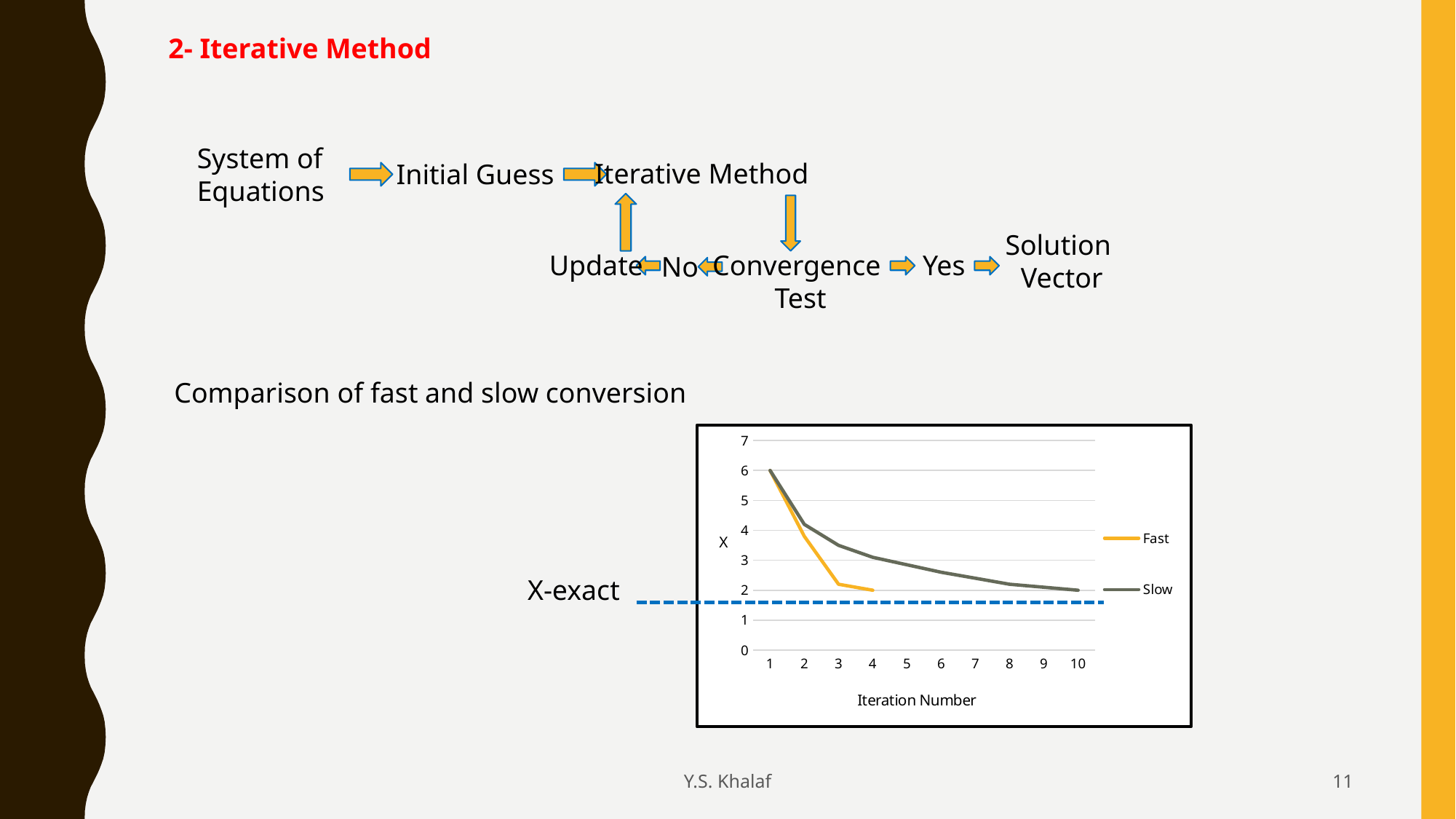
How many iteration numbers are shown on the chart's x axis? 10 At iteration 3, which series has the higher value, Fast or Slow? Slow What kind of chart is shown on the slide? line chart Is the value of the Fast series at iteration 2 greater or less than 5? less Is the value of the Slow series at iteration 5 greater or less than 2? greater What is the value of the Fast series at iteration 1? 6 How many series does the chart's legend list? 2 Is the value of the Fast series at iteration 3 greater or less than 3? less What are the two series named in the chart's legend? Fast and Slow Do the values of the Slow series rise or fall as the iteration number increases? fall What is the title of the chart's x axis? Iteration Number